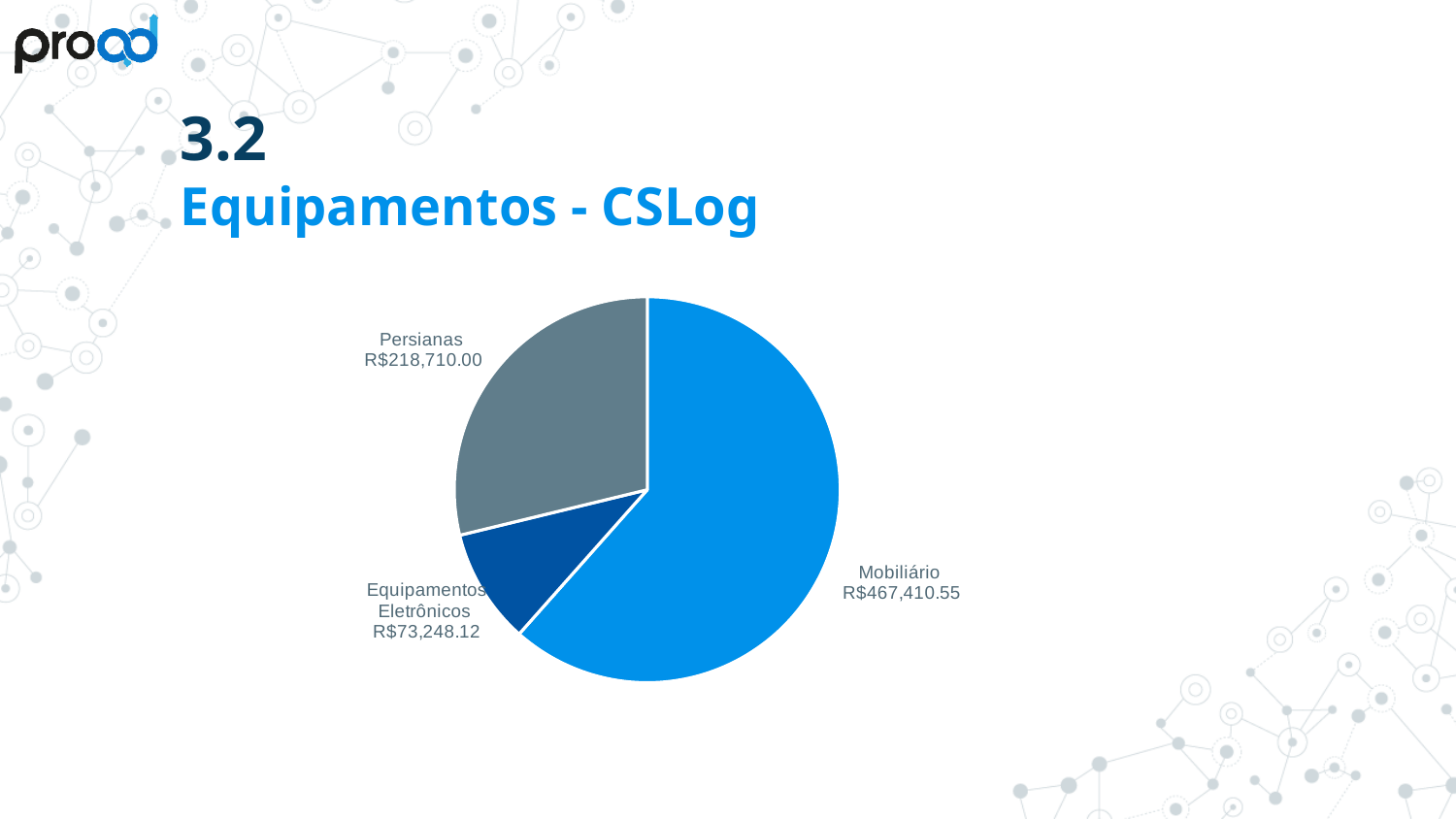
What is the total of all three slices in the pie chart? R$759,368.67 What is the value for Persianas in the pie chart? R$218,710.00 What is the value for Equipamentos Eletrônicos in the pie chart? R$73,248.12 What is the title of the slide containing the pie chart? Equipamentos - CSLog Which is larger, the value for Persianas or the value for Equipamentos Eletrônicos? Persianas What is the difference between the value for Persianas and the value for Equipamentos Eletrônicos? R$145,461.88 How many categories are shown in the pie chart? 3 Which category has the largest slice of the pie chart? Mobiliário What is the value for Mobiliário in the pie chart? R$467,410.55 What is the difference between the value for Mobiliário and the value for Persianas? R$248,700.55 What kind of chart is shown on the slide? Pie chart Which category has the smallest slice of the pie chart? Equipamentos Eletrônicos